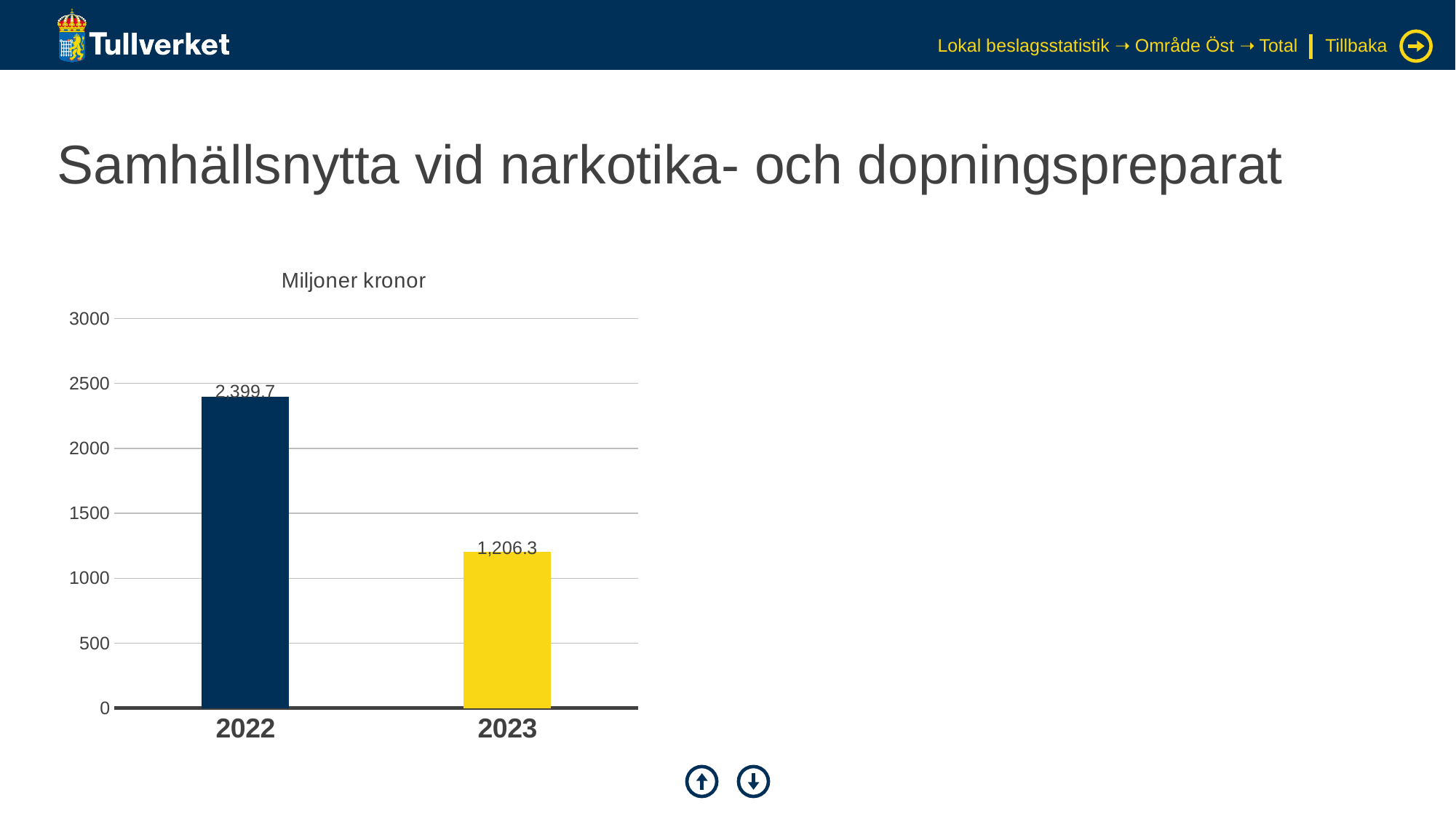
Which year has the highest value? 2022 What unit is shown above the chart? Miljoner kronor How many years are shown on the chart? 2 What kind of chart is shown on the slide? bar chart Is the value for 2022 greater or less than 2000? greater Which is larger, the value for 2022 or the value for 2023? 2022 What is the value for 2022? 2,399.7 Do the values rise or fall from 2022 to 2023? fall Which year has the lowest value? 2023 What is the value for 2023? 1,206.3 What is the difference between the values for 2022 and 2023? 1,193.4 Is the value for 2023 greater or less than 1500? less